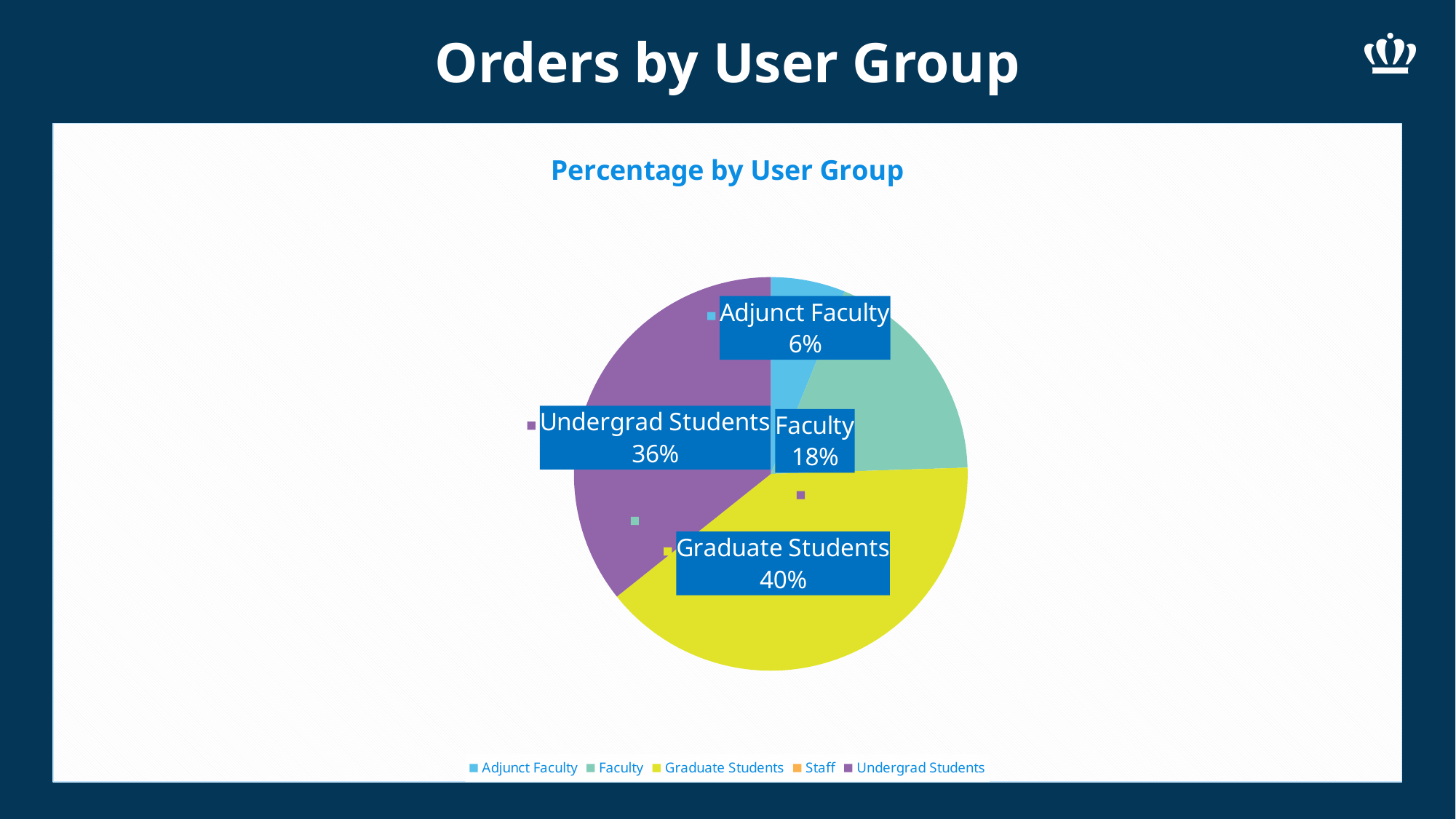
What kind of chart is shown on the slide? pie chart Which legend entry has no visible slice in the pie? Staff What percentage of orders comes from Graduate Students? 40% What percentage of orders comes from Adjunct Faculty? 6% What percentage of orders comes from Undergrad Students? 36% Which user group has the largest share of orders? Graduate Students Among the labelled slices, which user group has the smallest share of orders? Adjunct Faculty Which is larger, the share for Faculty or the share for Adjunct Faculty? Faculty How many user groups are listed in the legend? 5 What is the chart's title? Percentage by User Group What is the difference in percentage points between Graduate Students and Undergrad Students? 4 What percentage of orders comes from Faculty? 18%